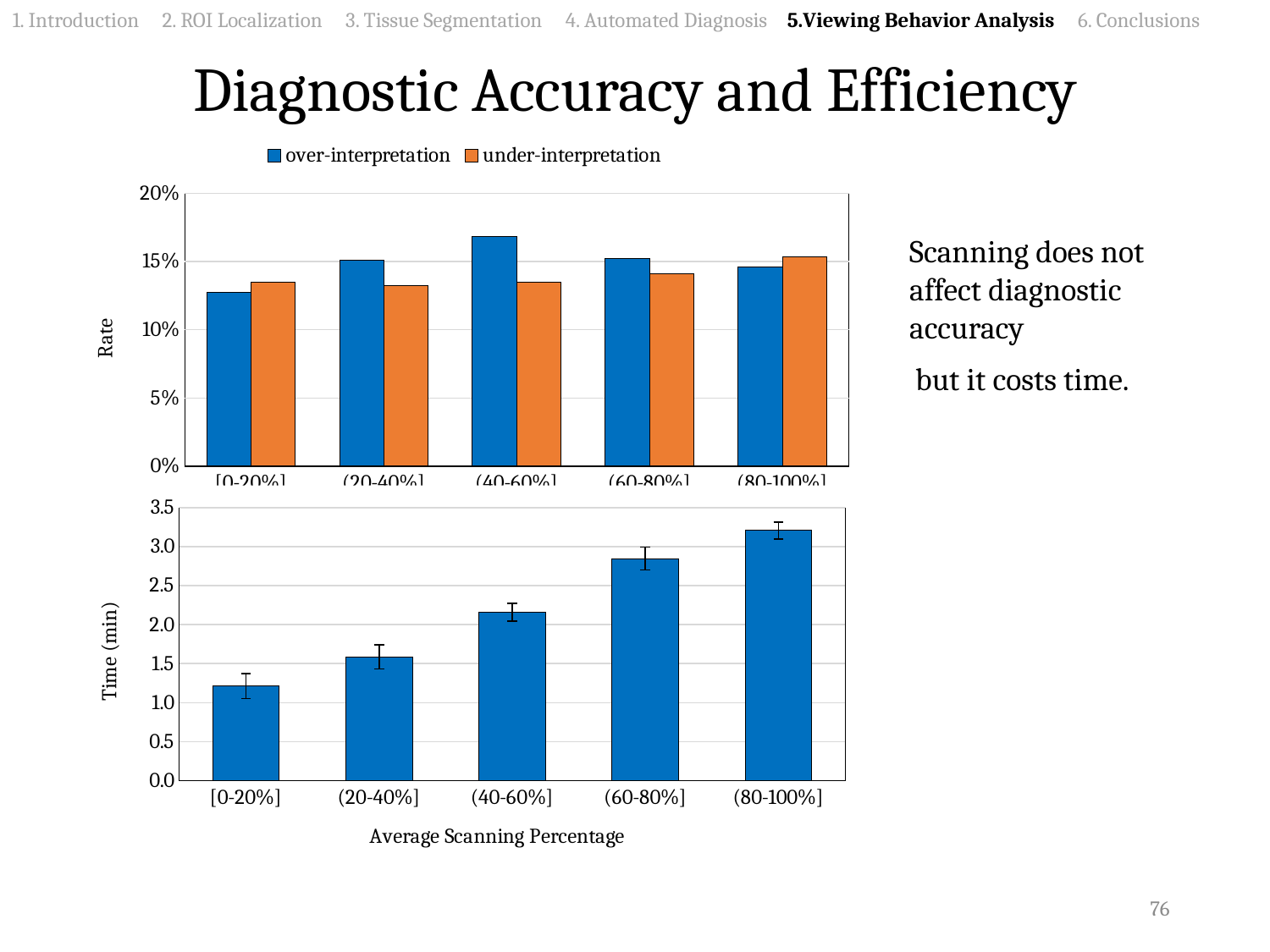
What kind of chart is the top chart (Rate)? bar chart In the bottom chart (Time (min)), which category has the lowest time? [0-20%] In the bottom chart (Time (min)), is the value for (80-100%] greater or less than 3.0? greater In the top chart, is the over-interpretation rate for (40-60%] greater or less than 15%? greater In the top chart, is the under-interpretation rate for [0-20%] greater or less than 15%? less In the top chart, for the [0-20%] category, which is larger: the over-interpretation rate or the under-interpretation rate? under-interpretation How many series does the legend of the top chart list? 2 In the top chart, which scanning percentage category has the lowest over-interpretation rate? [0-20%] In the top chart, which scanning percentage category has the highest under-interpretation rate? (80-100%] In the bottom chart (Time (min)), do the values rise or fall as the average scanning percentage increases? rise In the top chart, which scanning percentage category has the highest over-interpretation rate? (40-60%] In the bottom chart (Time (min)), how many scanning percentage categories are shown? 5